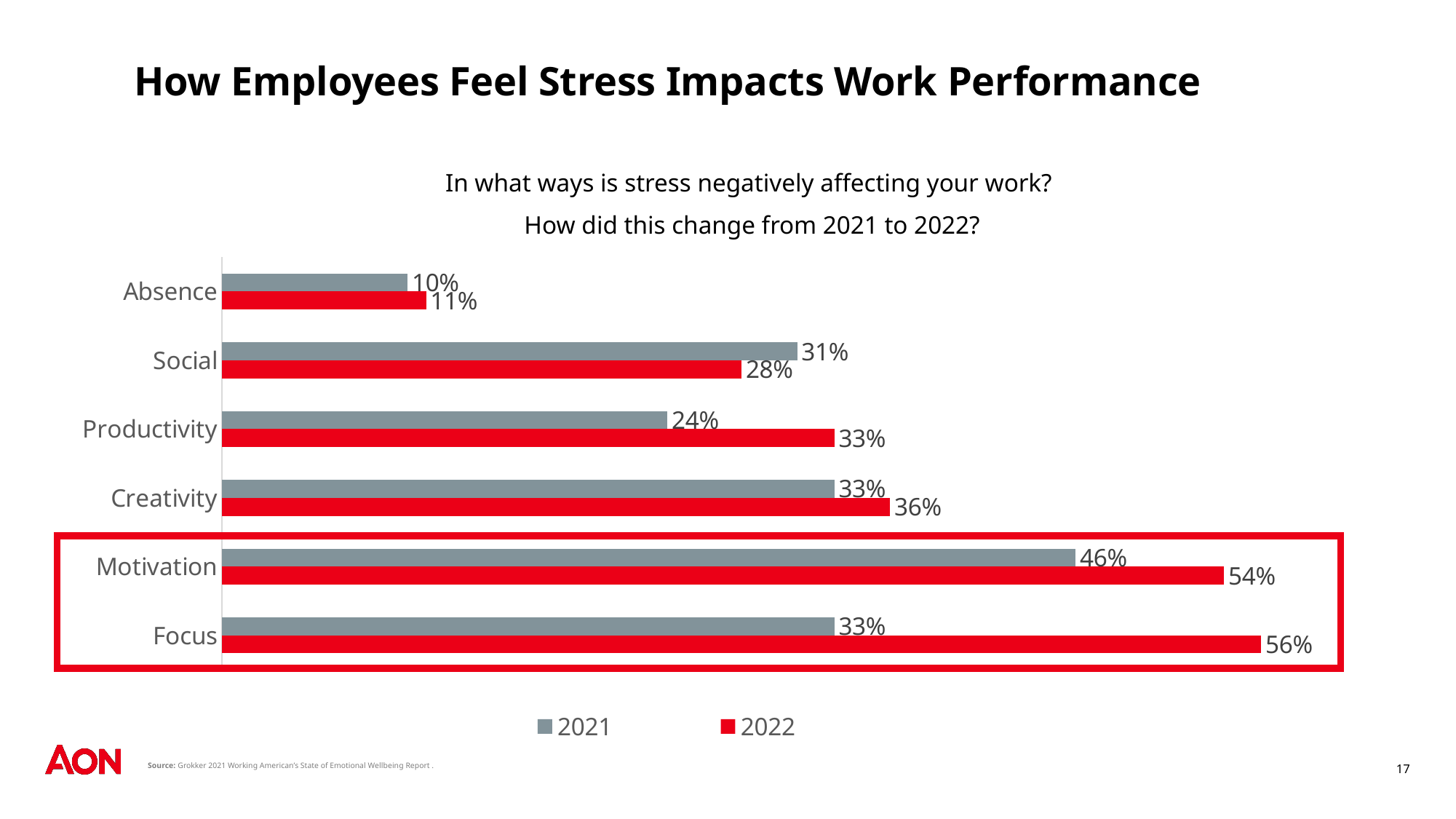
What is the difference between the 2022 and 2021 values for Motivation? 8% How many series does the legend list? 2 What is the difference between the 2022 and 2021 values for Focus? 23% Which is larger for Social: the 2021 value or the 2022 value? 2021 What is the 2022 value for Social? 28% What kind of chart is shown on the slide? Bar chart How many categories are shown on the chart? 6 What is the 2022 value for Focus? 56% Which category has the lowest 2021 value? Absence What is the 2021 value for Productivity? 24% Which category has the highest 2022 value? Focus Which colour represents the 2022 series in the legend? Red